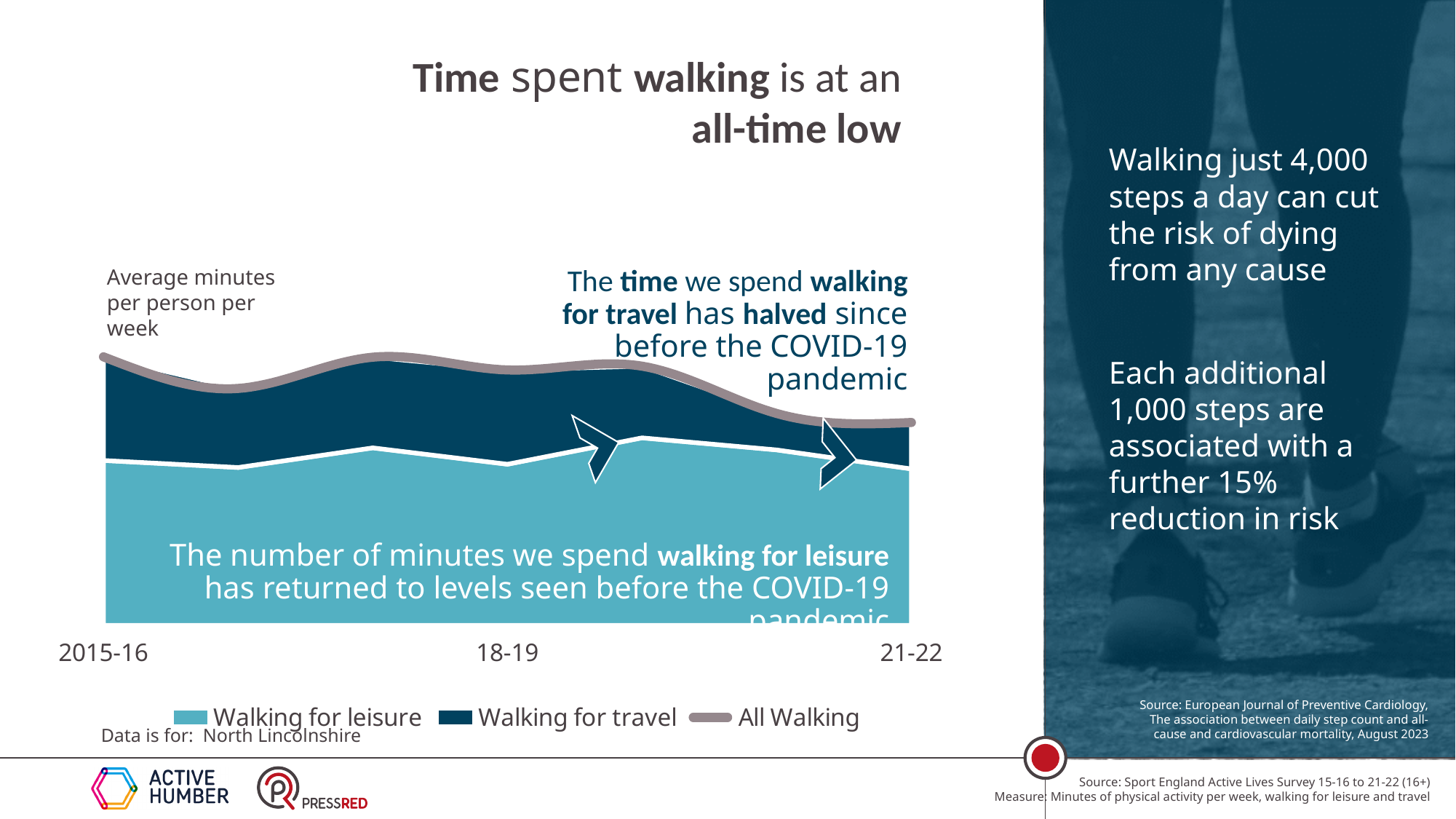
Does the All Walking line rise or fall from 2015-16 to 21-22? Fall How many series does the chart legend list? 3 What kind of chart is shown on the slide? Combination area and line chart Does the Walking for travel band get thicker or thinner from 18-19 to 21-22? Thinner What does the chart measure, according to the label at the top left of the chart? Average minutes per person per week Which area is the chart's data for? North Lincolnshire What is the title of the slide containing the chart? Time spent walking is at an all-time low How many year labels are shown on the x axis of the chart? 3 At which x-axis year is the All Walking line at its lowest? 21-22 At 21-22, which is larger: Walking for leisure or Walking for travel? Walking for leisure